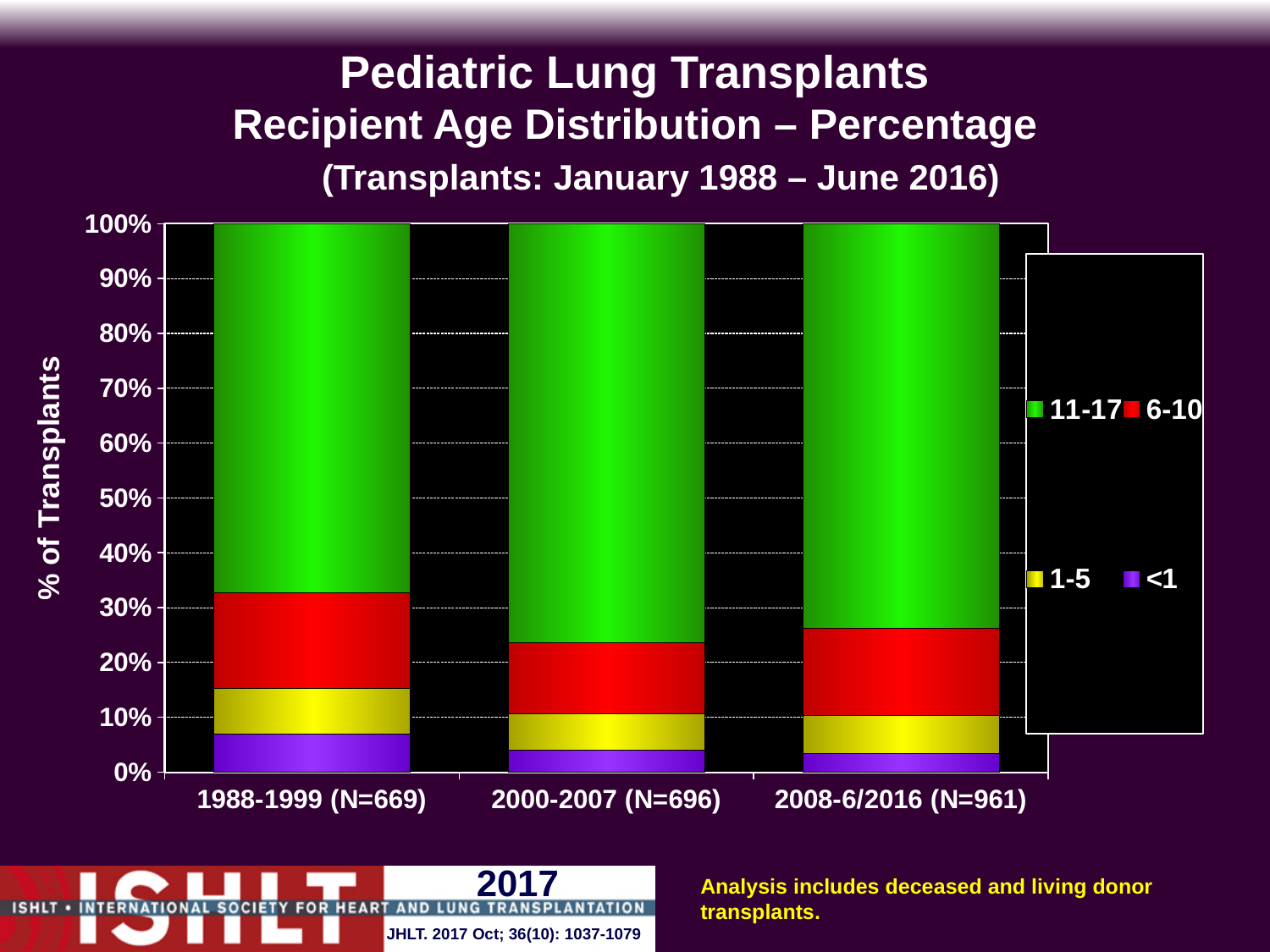
Is the share of recipients aged <1 in the 1988-1999 period greater or less than 10%? less Which period has the largest share of recipients aged <1? 1988-1999 (N=669) Is the share of recipients aged 11-17 in the 2000-2007 period greater or less than 70%? greater How many age groups does the legend list? 4 What is the number of transplants (N) for the 2008-6/2016 period? 961 Which age group makes up the largest share of transplants in the 2000-2007 period? 11-17 How many time periods (categories) are shown on the x axis? 3 Which age group makes up the smallest share of transplants in the 2008-6/2016 period? <1 Which period has the smallest share of recipients aged 11-17? 1988-1999 (N=669) Is the share of recipients aged <1 larger in 1988-1999 or in 2008-6/2016? 1988-1999 What kind of chart is shown on the slide? Stacked bar chart What is the label on the y axis? % of Transplants